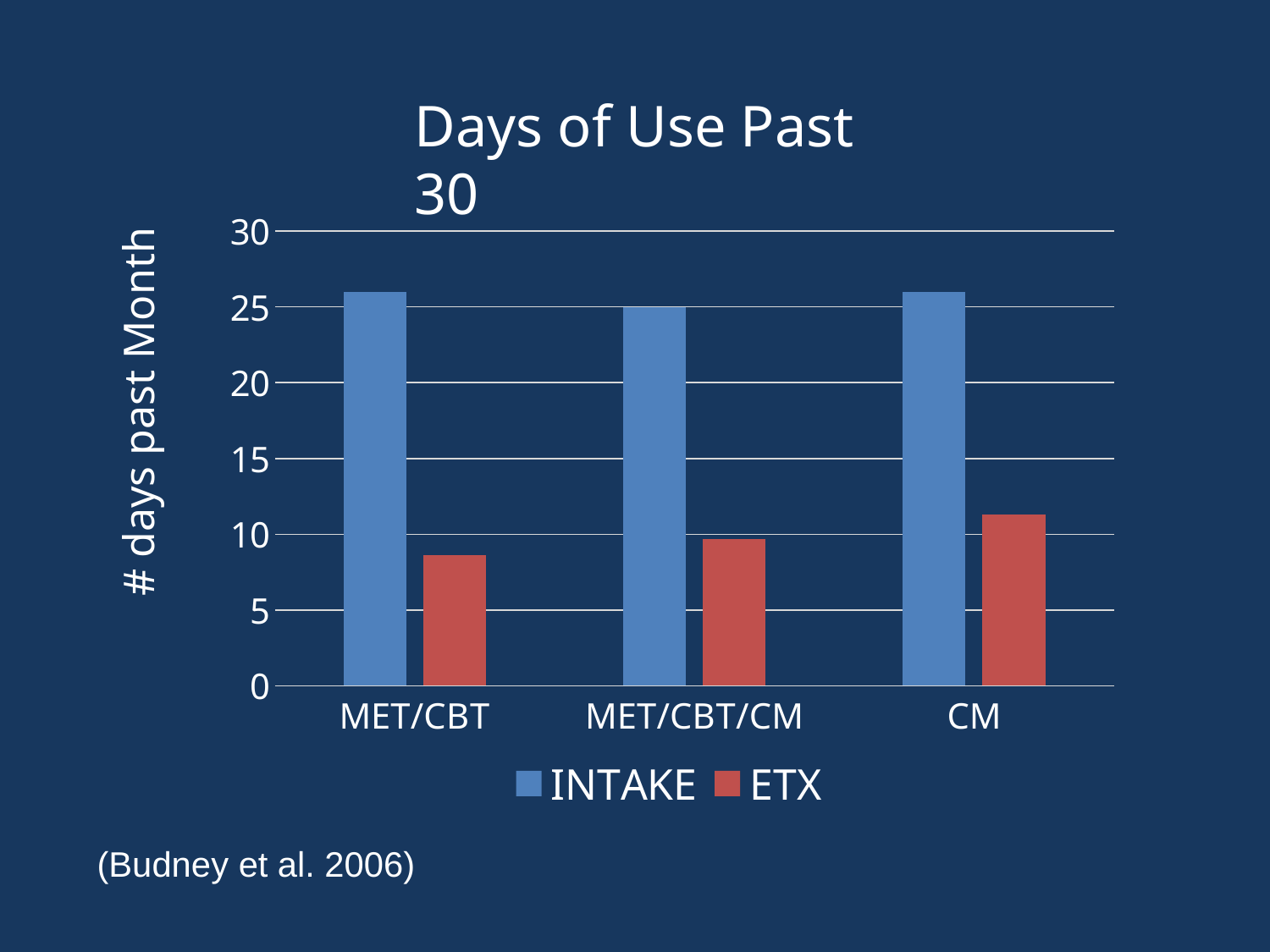
How many treatment categories are shown on the x axis? 3 What kind of chart is shown on the slide? bar chart Which category has the highest ETX value? CM Is the ETX value for CM greater or less than 10? greater Is the ETX value for MET/CBT greater or less than 10? less What is the INTAKE value for MET/CBT/CM? 25 What is the title of the chart? Days of Use Past 30 How many series does the legend list? 2 Is the INTAKE value for MET/CBT greater or less than 25? greater What is the label on the vertical axis? # days past Month Which category has the lowest ETX value? MET/CBT For CM, which is larger, the INTAKE value or the ETX value? INTAKE